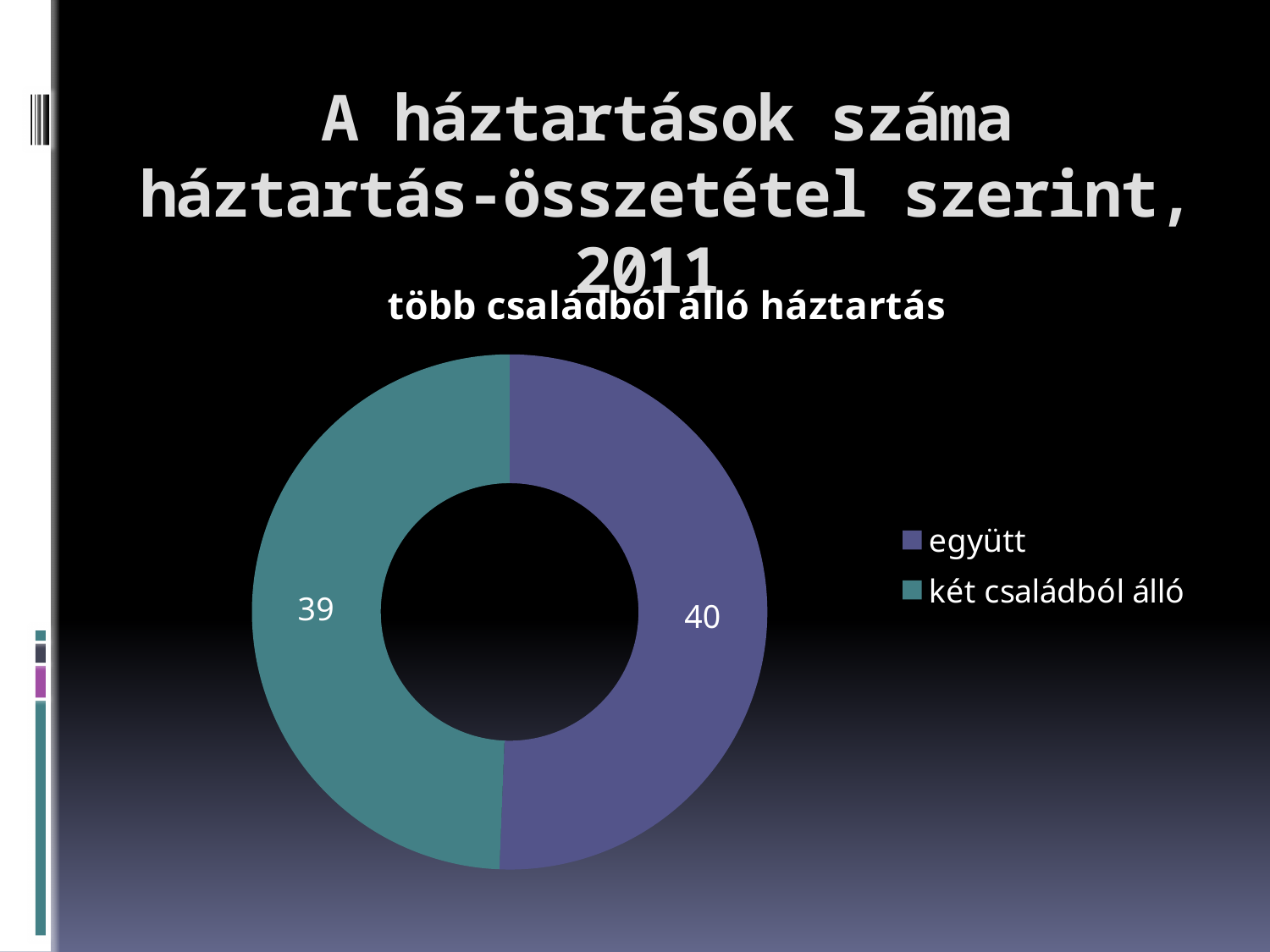
What is the difference between the values for "együtt" and "két családból álló"? 1 Which is larger, the value for "együtt" or the value for "két családból álló"? együtt What kind of chart is shown on the slide? doughnut chart What is the value for "együtt" in the chart? 40 How many entries does the legend list? 2 How many categories are shown in the chart? 2 What colour is the "két családból álló" slice in the chart? teal What is the value for "két családból álló" in the chart? 39 What is the title of the chart? több családból álló háztartás Which category has the lowest value in the chart? két családból álló Which category has the highest value in the chart? együtt What is the total of the two values shown in the chart? 79